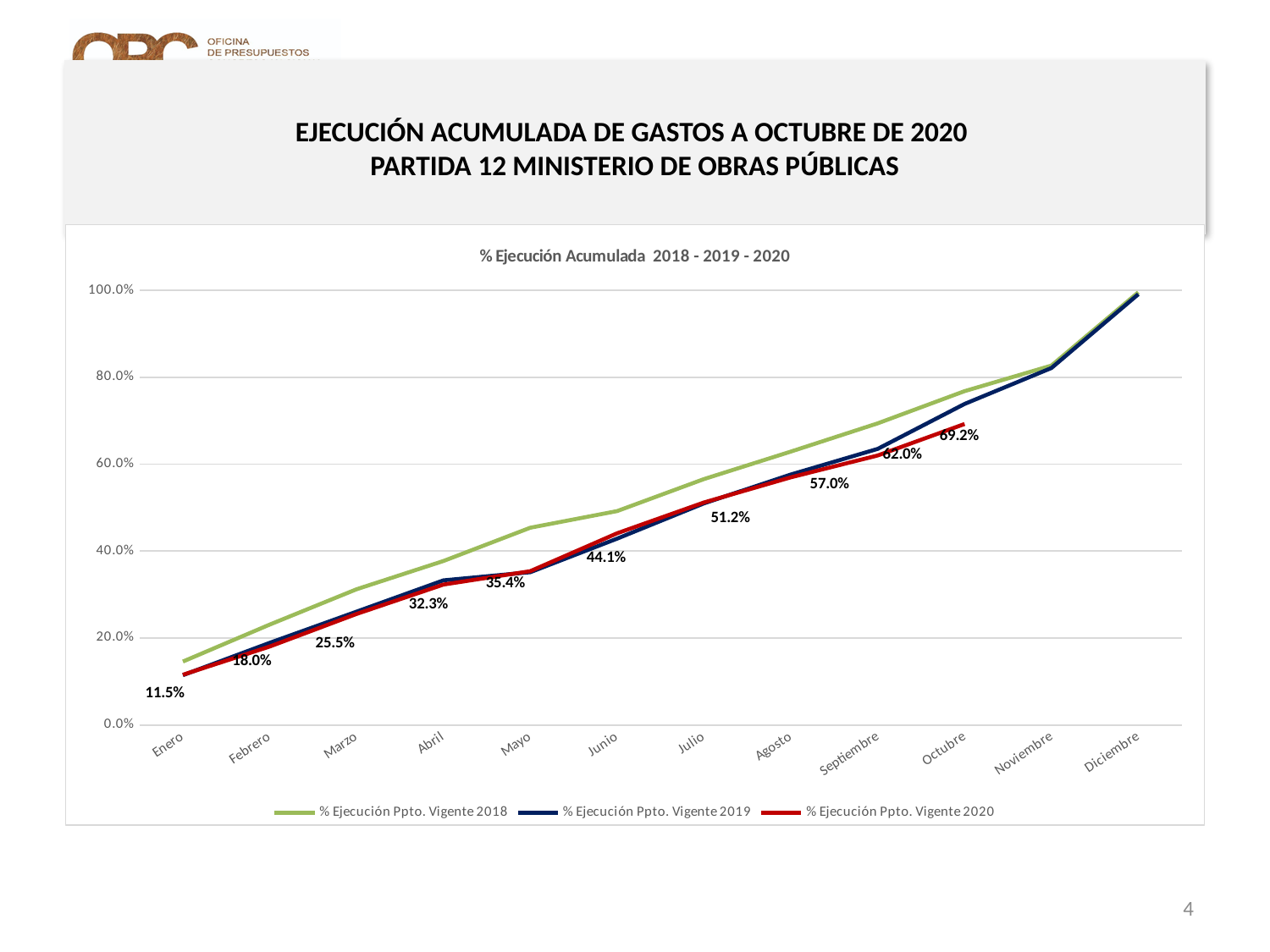
What kind of chart is shown on the slide? line chart How many series does the legend list? 3 What is the value for % Ejecución Ppto. Vigente 2020 in Enero? 11.5% What is the value for % Ejecución Ppto. Vigente 2020 in Junio? 44.1% How many months are shown along the x axis? 12 Does the % Ejecución Ppto. Vigente 2020 series rise or fall from Enero to Octubre? rise What is the value for % Ejecución Ppto. Vigente 2020 in Octubre? 69.2% What is the difference between the 2020 values for Julio and Enero? 39.7% What is the title of the chart? % Ejecución Acumulada 2018 - 2019 - 2020 Which series is higher in Marzo, % Ejecución Ppto. Vigente 2018 or % Ejecución Ppto. Vigente 2020? % Ejecución Ppto. Vigente 2018 What is the difference between the 2020 values for Octubre and Septiembre? 7.2% Is the value for % Ejecución Ppto. Vigente 2018 in Mayo greater or less than 40.0%? greater